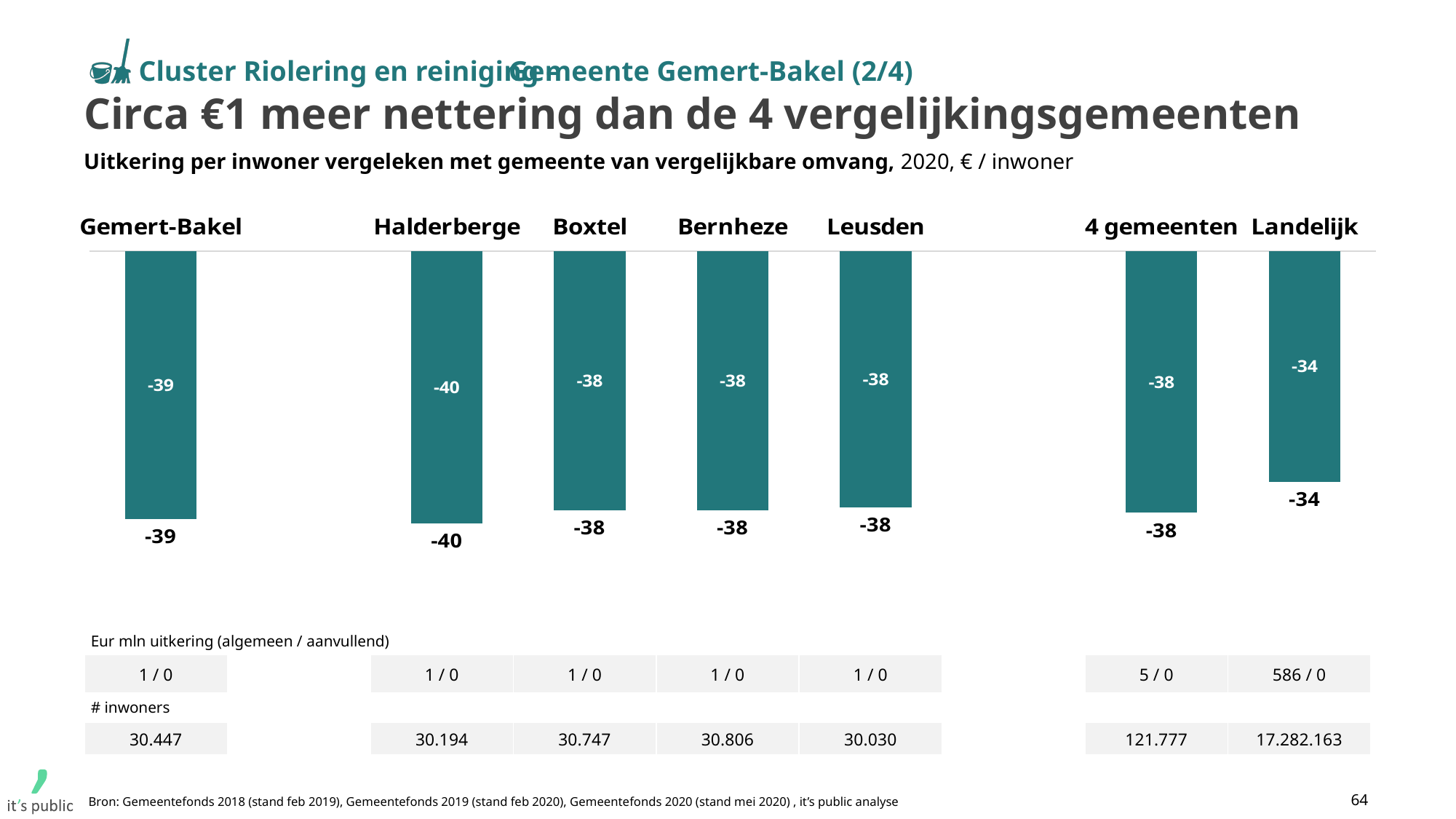
What is the difference between the values for Gemert-Bakel and 4 gemeenten? 1 Which category has the lowest value? Halderberge What is the difference between the values for Halderberge and Landelijk? 6 What is the value for Gemert-Bakel? -39 What is the value for Landelijk? -34 What is the value for Halderberge? -40 Which is larger, the value for Landelijk or the value for Halderberge? Landelijk What is the value for 4 gemeenten? -38 How many bars are shown in the chart? 7 Which category has the highest value? Landelijk What unit is stated in the chart subtitle? € / inwoner What kind of chart is shown on the slide? Bar chart